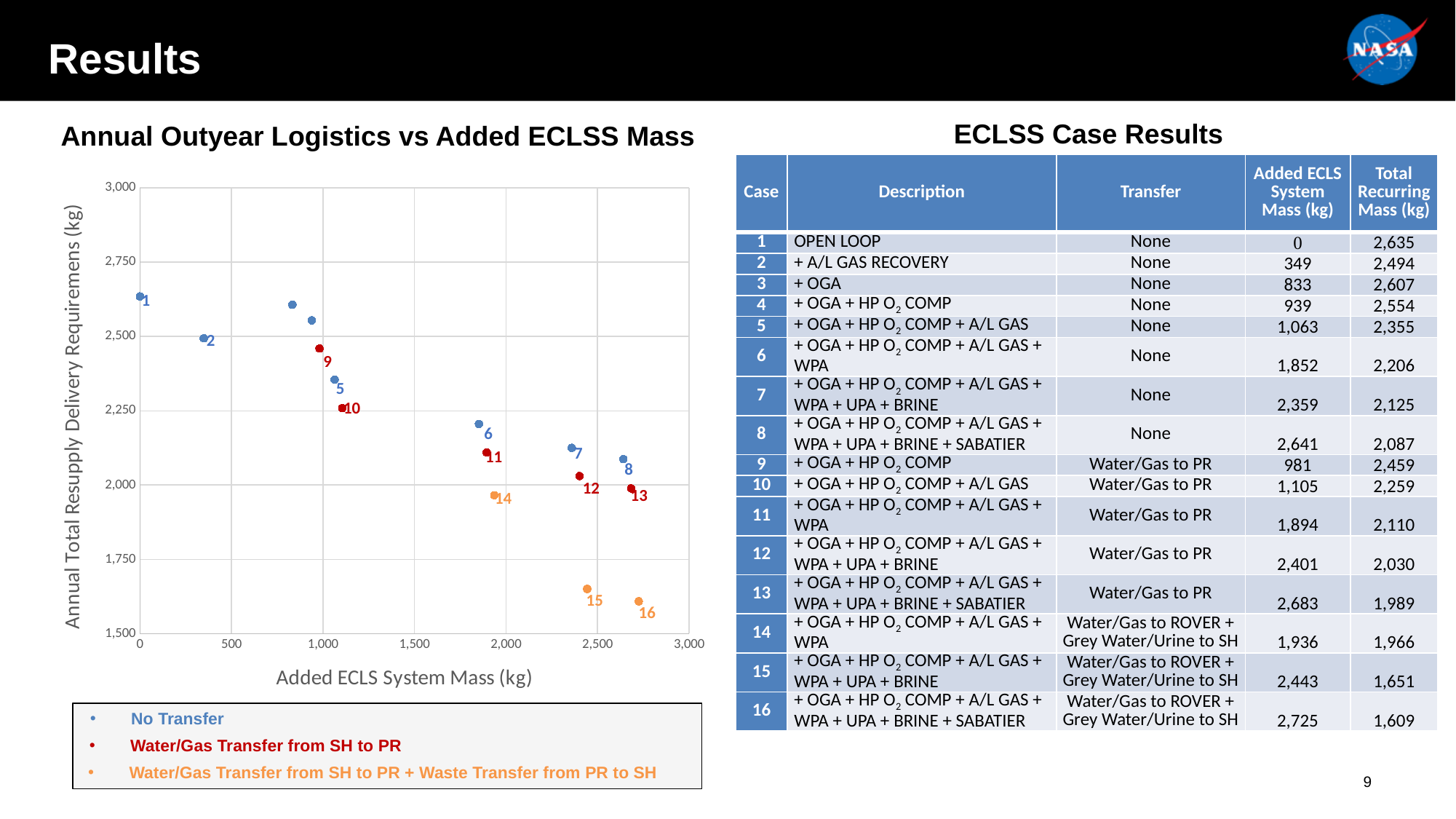
On the scatter chart, is the Annual Total Resupply Delivery Requirement for point 1 greater or less than 2,500? greater On the scatter chart, is the Annual Total Resupply Delivery Requirement for point 5 greater or less than 2,250? greater On the scatter chart, which has the higher Annual Total Resupply Delivery Requirement, point 7 or point 15? Point 7 Which labelled point on the scatter chart has the highest Annual Total Resupply Delivery Requirement? 1 On the scatter chart, is the Added ECLS System Mass for point 13 greater or less than 2,500? greater What colour are the 'No Transfer' points on the scatter chart? Blue What kind of chart is shown under the title 'Annual Outyear Logistics vs Added ECLSS Mass'? Scatter chart On the scatter chart, do the Annual Total Resupply Delivery Requirements generally rise or fall as Added ECLS System Mass increases? Fall How many series does the legend of the scatter chart list? 3 Which labelled point on the scatter chart has the lowest Annual Total Resupply Delivery Requirement? 16